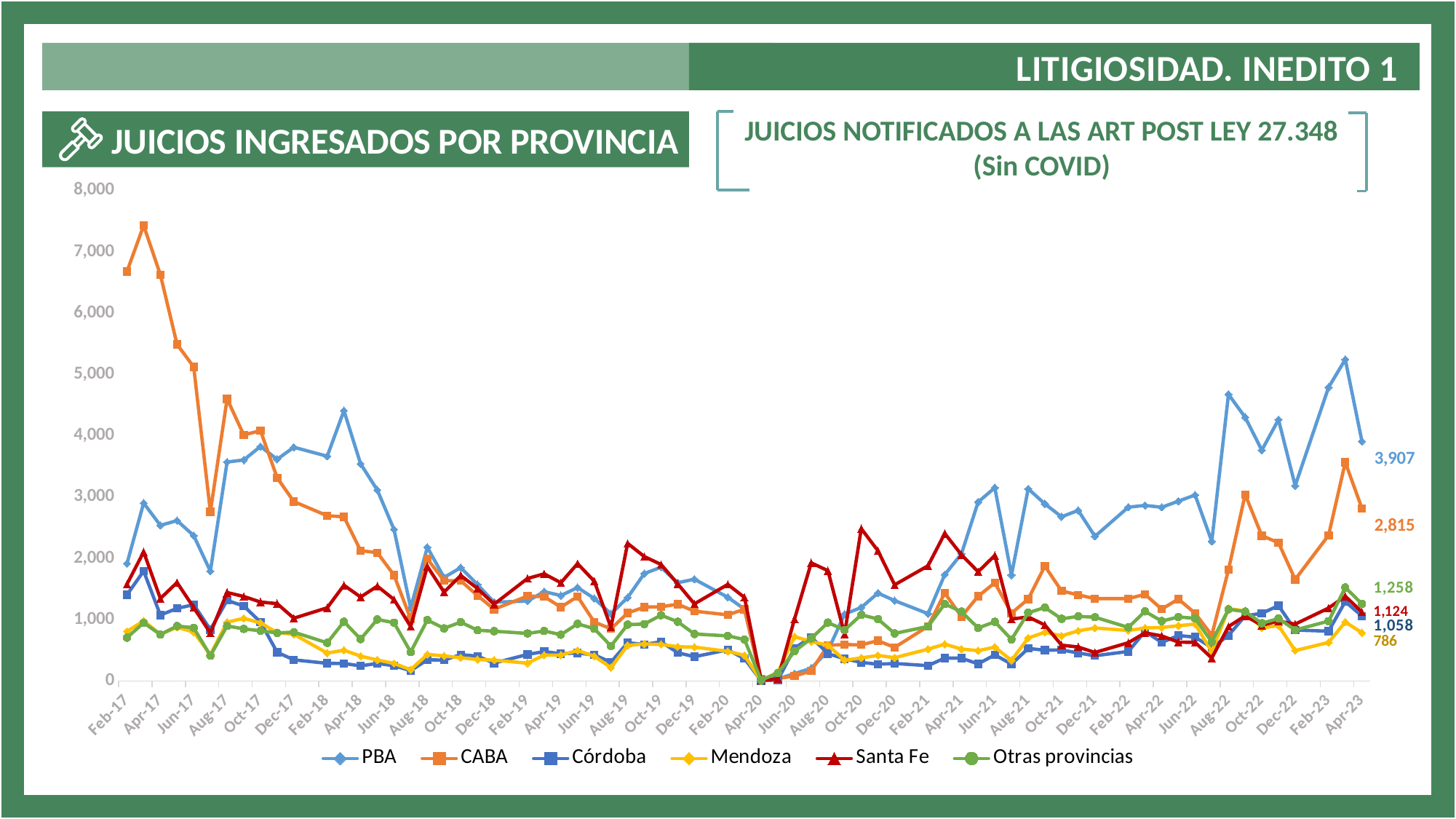
What is the value for PBA at Apr-23? 3,907 What is the value for CABA at Apr-23? 2,815 Which series has the lowest value at Apr-23? Mendoza What is the value for Otras provincias at Apr-23? 1,258 Which series has the highest value at Apr-23? PBA What kind of chart is shown on the slide? line chart How many series does the legend list? 6 What is the title of the chart? JUICIOS INGRESADOS POR PROVINCIA What is the difference between the PBA and CABA values at Apr-23? 1,092 Is the value for CABA at Apr-17 greater or less than 7,000? less What is the value for Mendoza at Apr-23? 786 At Apr-23, which is larger: Santa Fe or Córdoba? Santa Fe